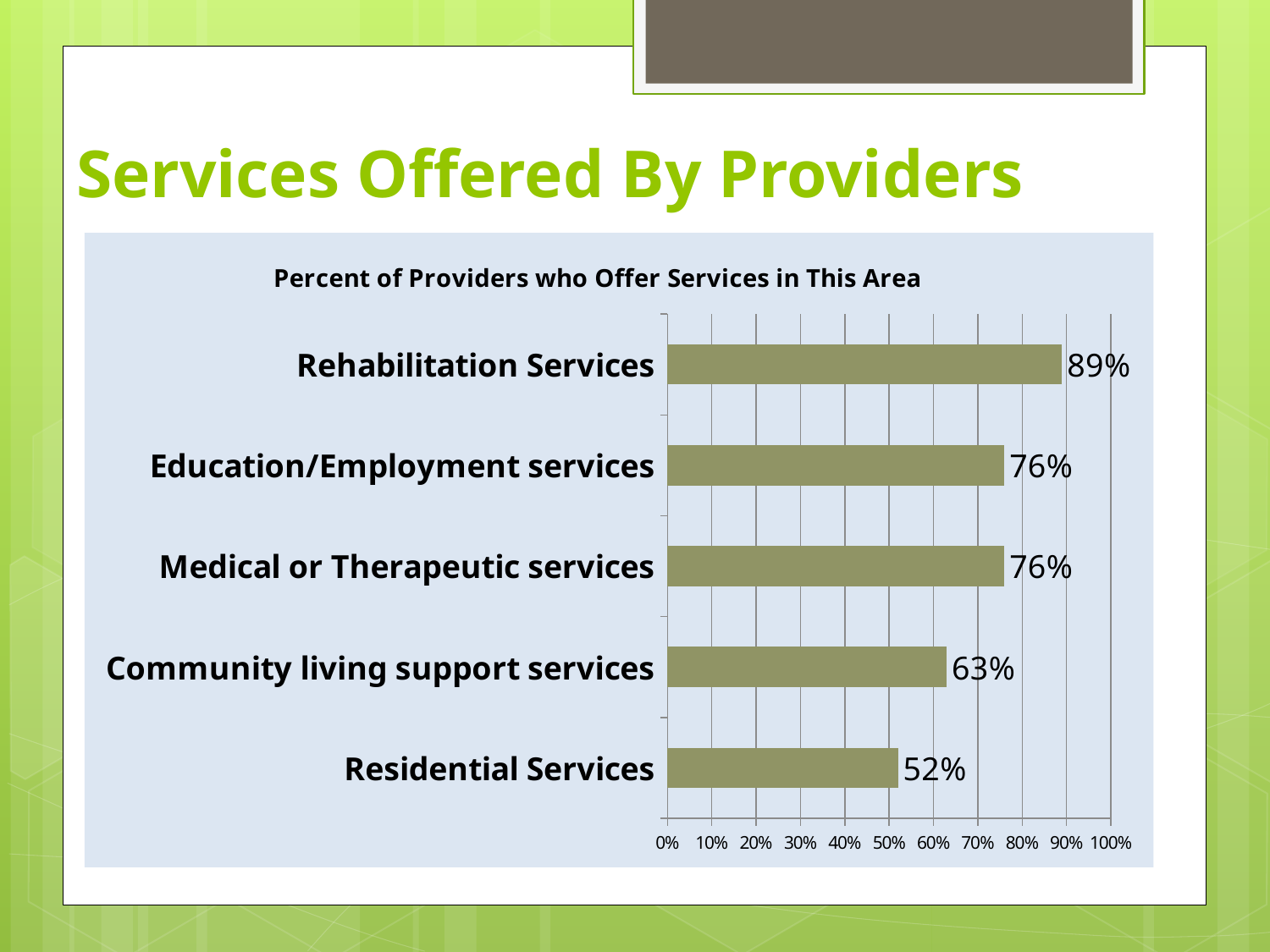
Which is larger, the value for Community living support services or the value for Residential Services? Community living support services Which service area has the highest percent of providers offering it? Rehabilitation Services What percent of providers offer Residential Services? 52% Which service area has the lowest percent of providers offering it? Residential Services What is the difference in percentage points between Rehabilitation Services and Residential Services? 37 What kind of chart is shown on the slide? Bar chart How many service areas are shown in the chart? 5 What percent of providers offer Rehabilitation Services? 89% What is the difference in percentage points between Medical or Therapeutic services and Community living support services? 13 What is the title of the chart? Percent of Providers who Offer Services in This Area What percent of providers offer Education/Employment services? 76% What percent of providers offer Community living support services? 63%